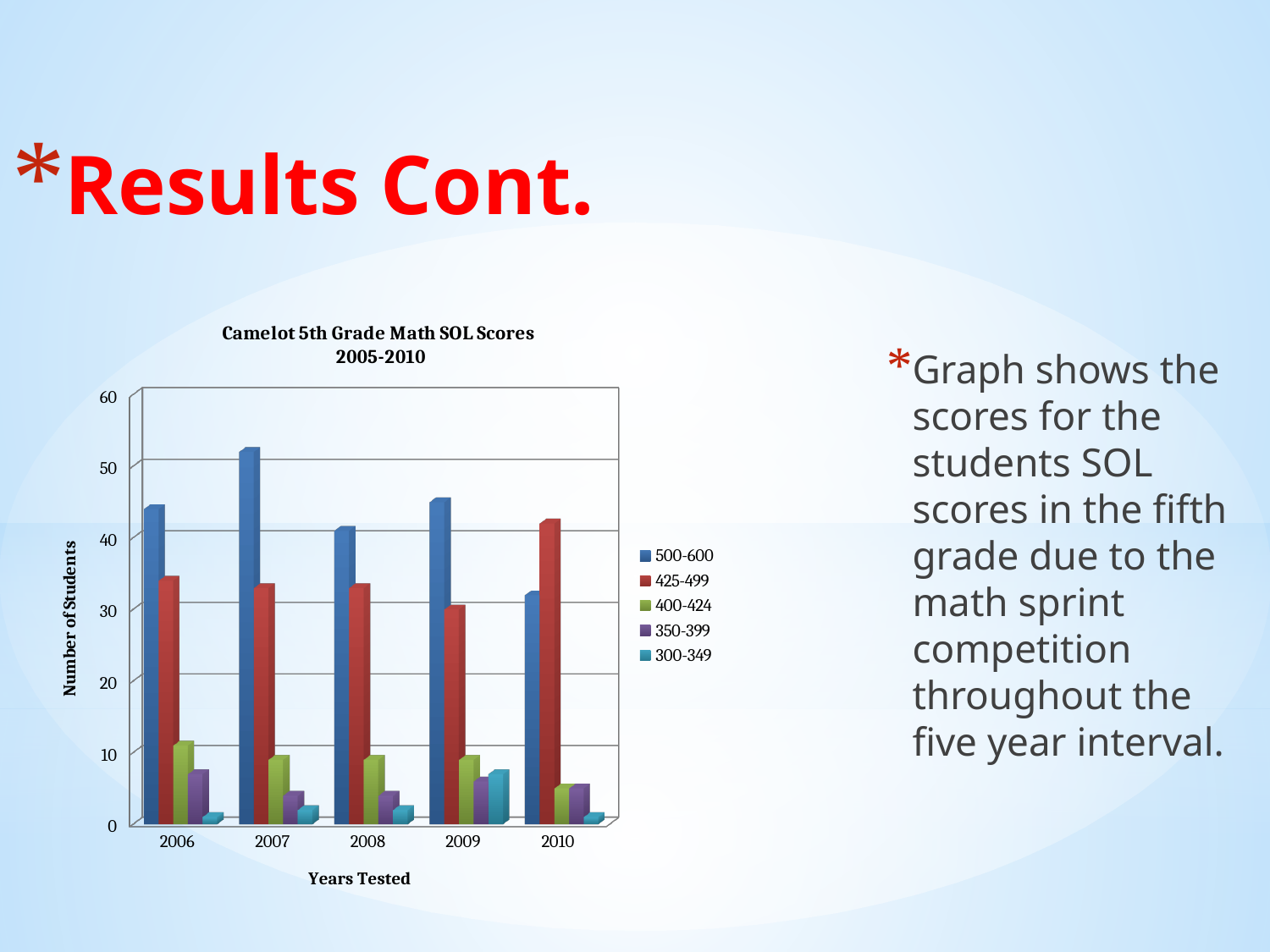
In 2006, which is larger: the 500-600 bar or the 425-499 bar? 500-600 How many series does the chart's legend list? 5 Is the value for 500-600 in 2007 greater or less than 50? greater What is the label on the chart's vertical axis? Number of Students How many years are shown on the x axis of the chart? 5 Is the value for 425-499 in 2010 greater or less than 40? greater In which year is the 500-600 bar the shortest? 2010 In which year is the 500-600 bar the tallest? 2007 What kind of chart is shown on the slide? bar chart What is the title of the chart? Camelot 5th Grade Math SOL Scores 2005-2010 In 2010, which is larger: the 500-600 bar or the 425-499 bar? 425-499